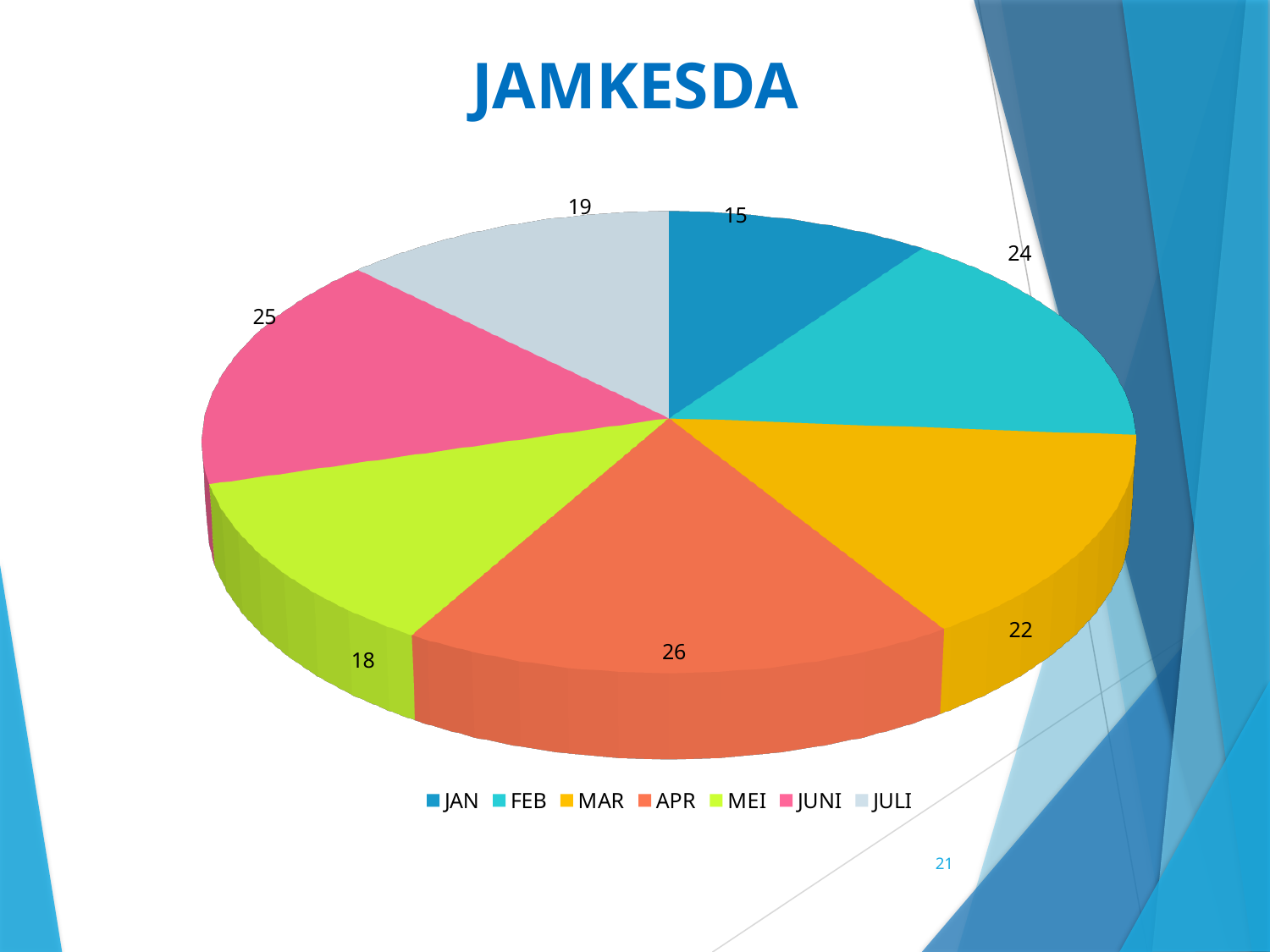
What is the difference between the values for FEB and MAR in the JAMKESDA pie chart? 2 Which is larger in the JAMKESDA pie chart, JULI or MEI? JULI Which month has the largest slice in the JAMKESDA pie chart? APR What is the title of the chart on the slide? JAMKESDA What kind of chart is shown on the slide? Pie chart How many slices does the JAMKESDA pie chart have? 7 What is the value for MEI in the JAMKESDA pie chart? 18 What is the value for JUNI in the JAMKESDA pie chart? 25 What is the value for APR in the JAMKESDA pie chart? 26 What is the value for JAN in the JAMKESDA pie chart? 15 Which month has the smallest slice in the JAMKESDA pie chart? JAN What is the difference between the values for APR and JAN in the JAMKESDA pie chart? 11